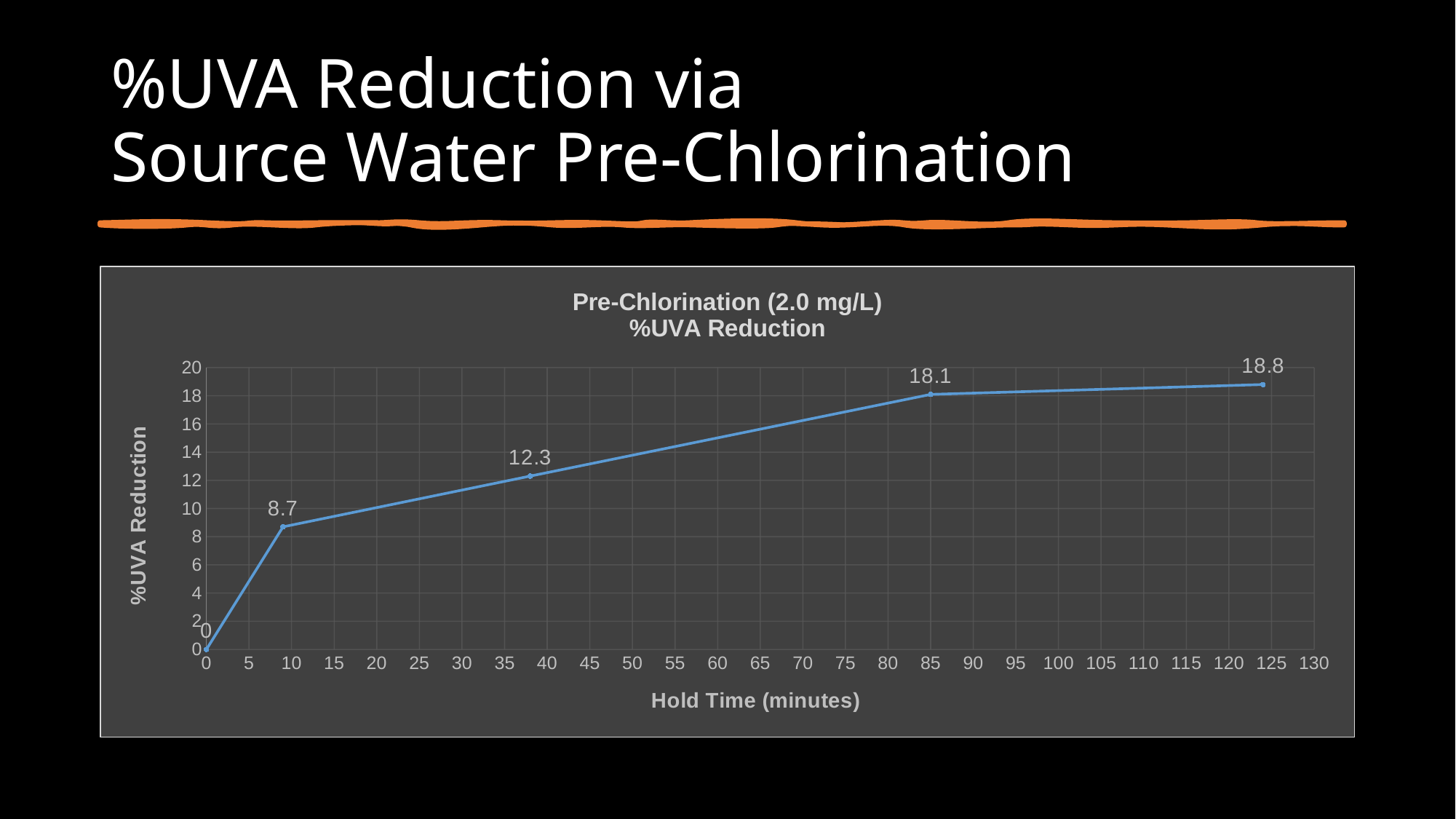
What is the difference between the third data point (12.3) and the second data point (8.7)? 3.6 What is the %UVA Reduction value of the second data point on the line? 8.7 What is the highest %UVA Reduction value shown on the chart? 18.8 What is the %UVA Reduction value at a hold time of 0 minutes? 0 What is the %UVA Reduction value of the third data point on the line? 12.3 What is the label of the x axis? Hold Time (minutes) What is the difference between the last data point (18.8) and the fourth data point (18.1)? 0.7 What kind of chart is shown on the slide? Line chart Does the %UVA Reduction rise or fall as hold time increases? Rises How many data points are plotted on the line? 5 What is the %UVA Reduction value of the fourth data point on the line? 18.1 Which is larger, the fourth data point or the third data point? The fourth data point (18.1)